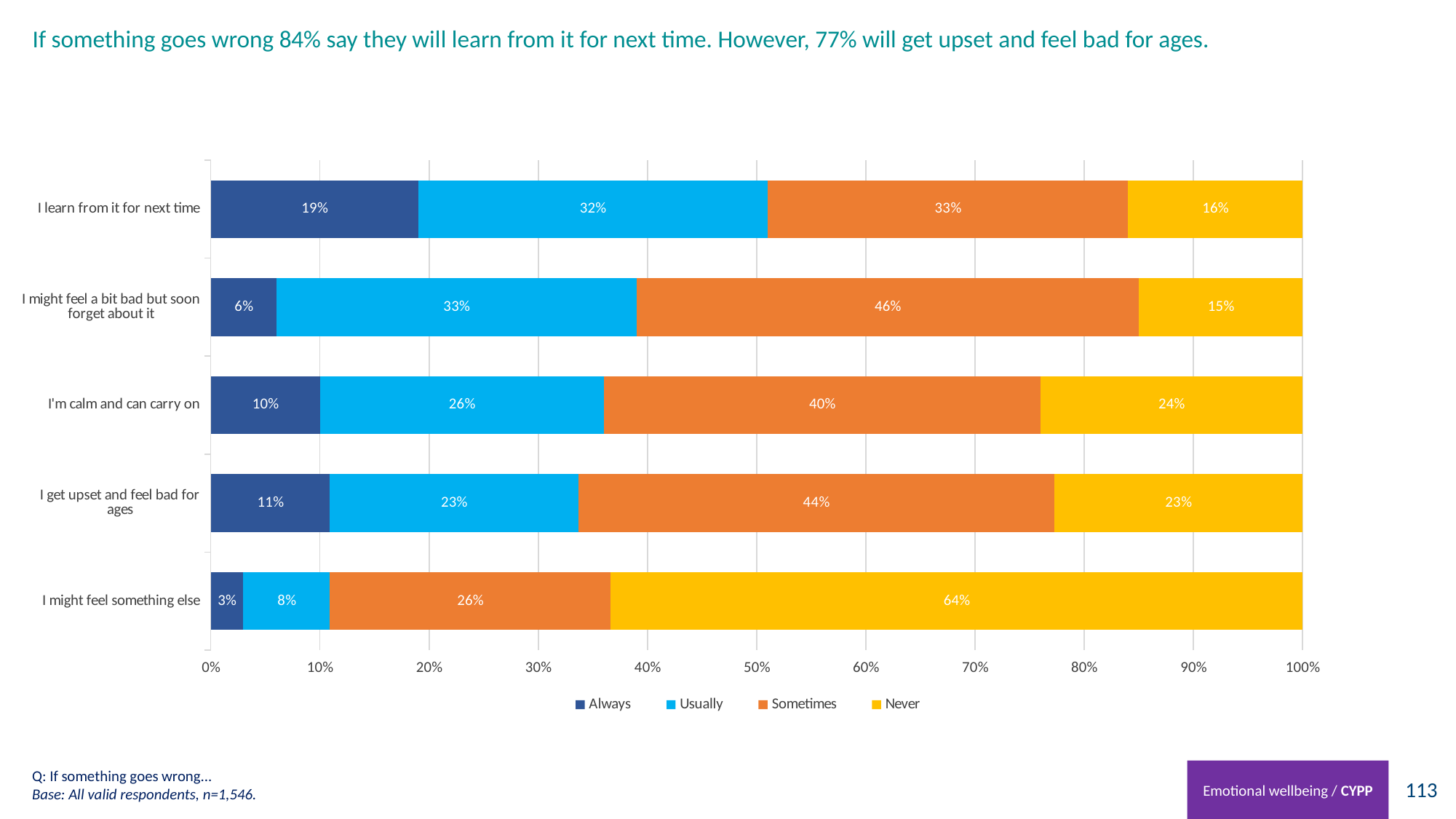
What is the combined 'Always' and 'Usually' value for 'I learn from it for next time'? 51% How many series does the legend list? 4 Which category has the lowest 'Always' value? I might feel something else Which category has the highest 'Never' value? I might feel something else What kind of chart is shown on the slide? Stacked bar chart What is the difference between the 'Sometimes' values for 'I get upset and feel bad for ages' and 'I learn from it for next time'? 11% What is the 'Never' value for 'I might feel something else'? 64% Which series is shown in yellow in the legend? Never What percentage of respondents say they 'Always' learn from it for next time? 19% How many categories are shown on the chart? 5 What is the 'Sometimes' value for 'I might feel a bit bad but soon forget about it'? 46% Which is larger: the 'Usually' value for 'I'm calm and can carry on' or for 'I get upset and feel bad for ages'? I'm calm and can carry on